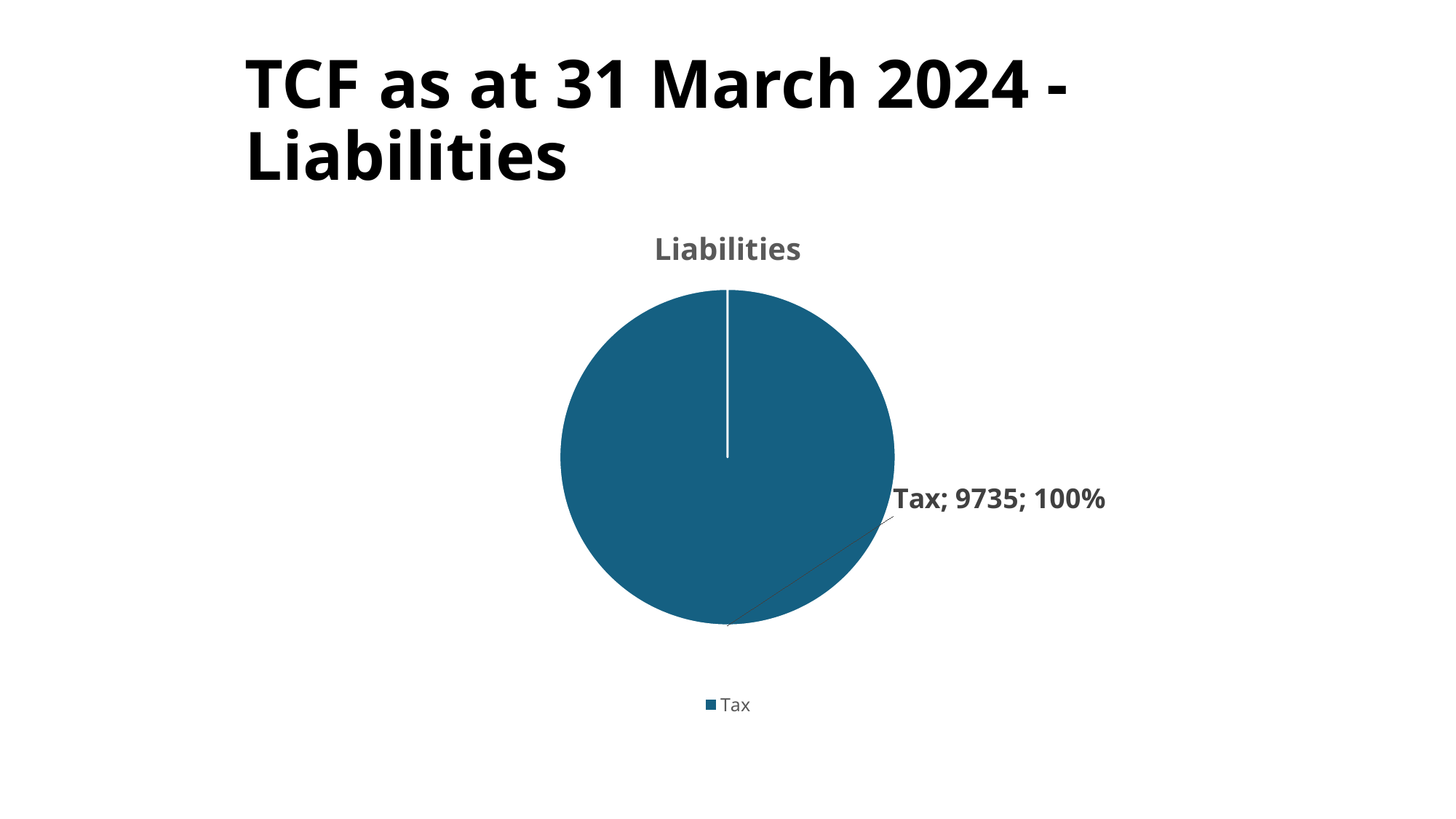
Is the value for Tax in the Liabilities chart greater or less than 9000? greater Which category is the largest in the Liabilities pie chart? Tax What category is listed in the legend of the Liabilities chart? Tax How many entries does the legend of the Liabilities chart list? 1 What kind of chart is shown on the slide? pie chart What is the value for Tax in the Liabilities pie chart? 9735 How many slices does the Liabilities pie chart have? 1 What share of the Liabilities pie does the Tax slice represent? 100% What is the title of the chart on the slide? Liabilities